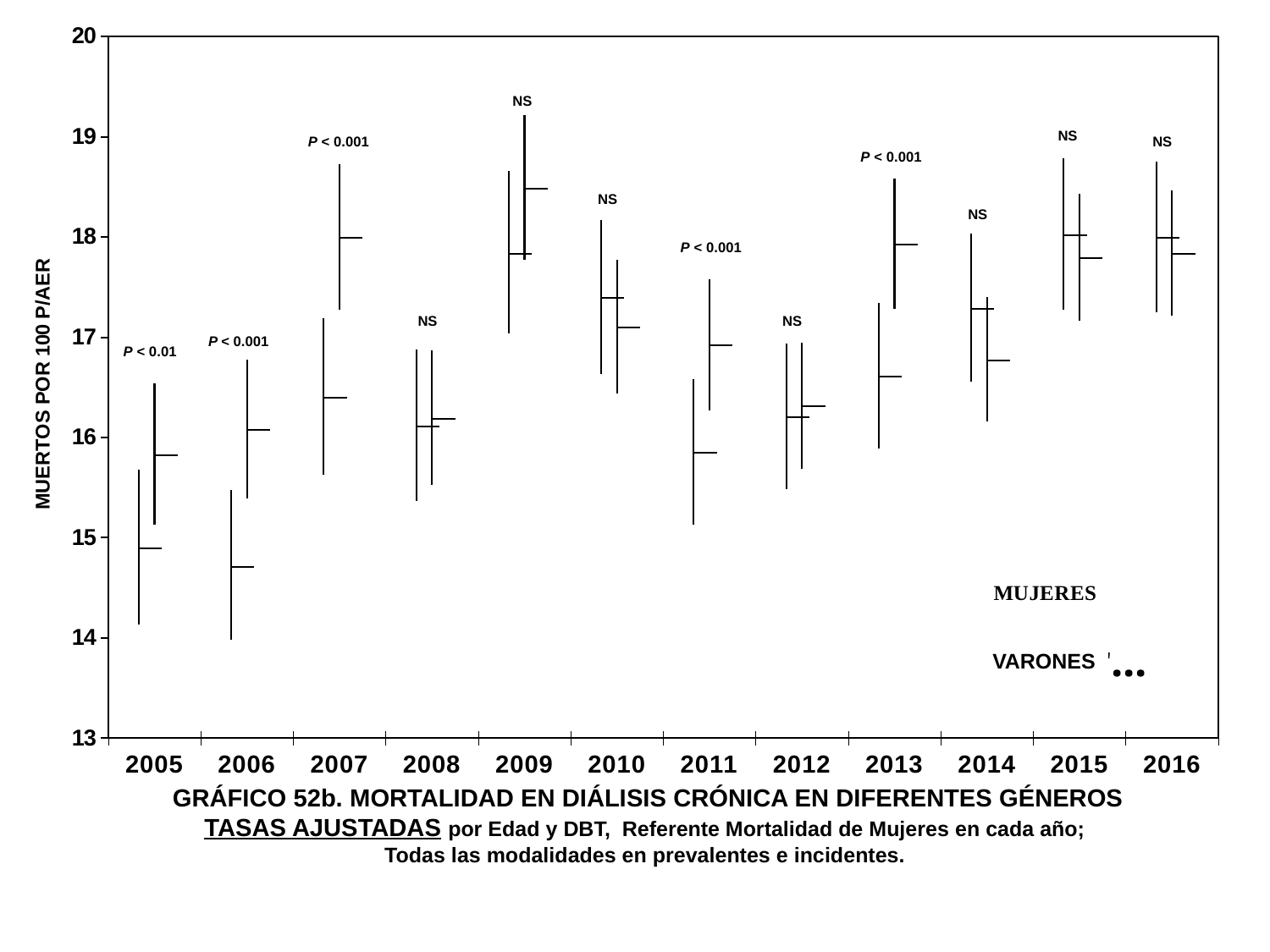
What significance annotation is printed above the 2005 bars? P < 0.01 How many years are annotated with NS? 7 Is the midpoint of the right bar for 2009 greater or less than 18? greater What is the title of the chart? GRÁFICO 52b. MORTALIDAD EN DIÁLISIS CRÓNICA EN DIFERENTES GÉNEROS What significance annotation is printed above the 2009 bars? NS How many years are annotated with P < 0.001? 4 How many years are shown on the x axis of the chart? 12 How many series does the legend list? 2 Overall, do the mortality rates rise or fall from 2005 to 2016? rise Is the midpoint of the left bar for 2006 greater or less than 15? less What is the label of the y axis? MUERTOS POR 100 P/AER Is the midpoint of the right bar for 2007 greater or less than 17? greater